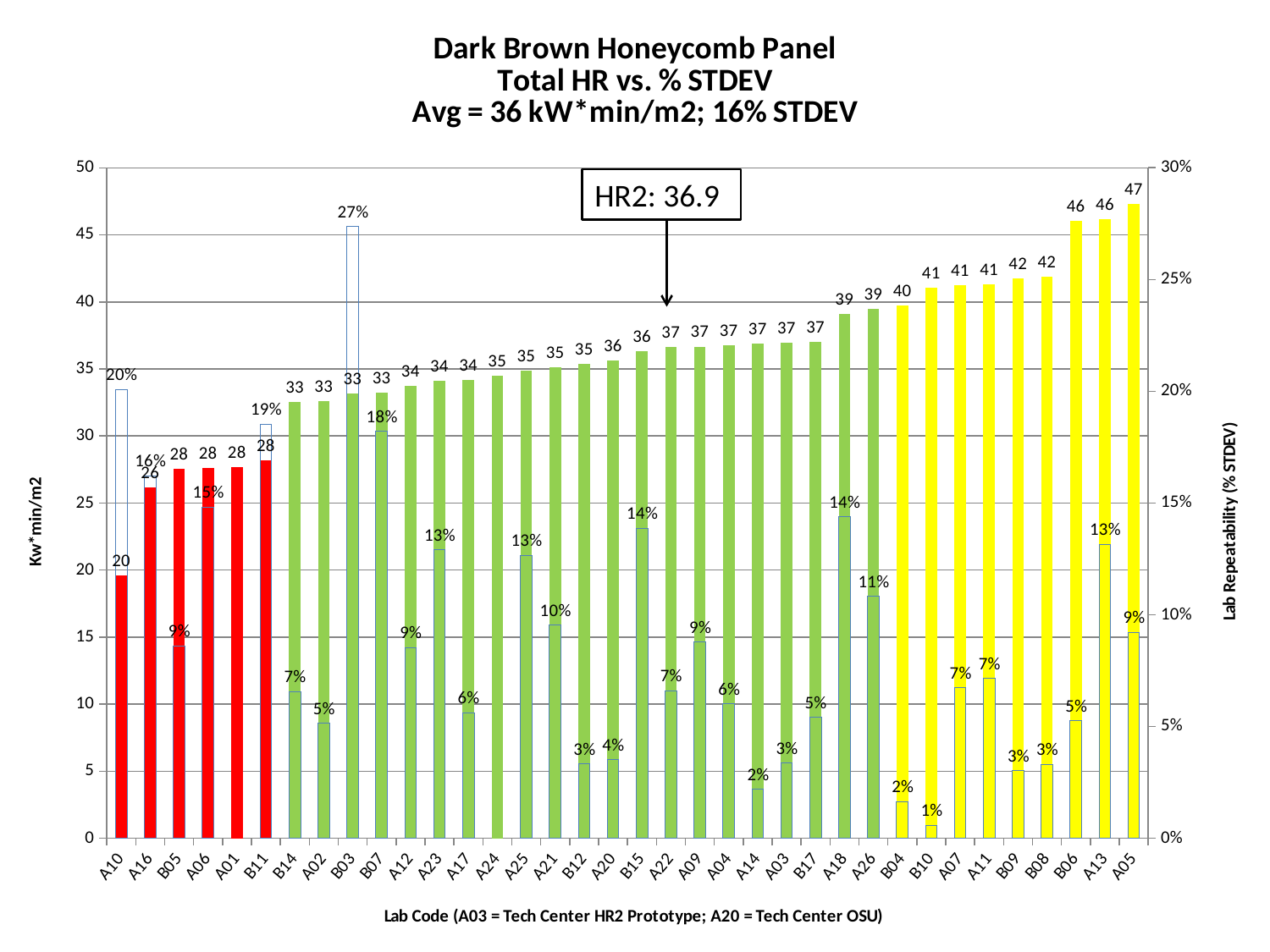
What HR2 value is shown in the annotation box on the chart? 36.9 Which lab code has the lowest Total HR value? A10 Which lab code has the highest % STDEV value? B03 What is the % STDEV value shown for lab A18? 14% Which lab code has the lowest % STDEV value? B10 Which lab has a higher Total HR value, B06 or B04? B06 How many lab codes are shown on the x axis? 36 What is the Total HR value for lab A05? 47 Which lab code has the highest Total HR value? A05 What is the lab repeatability (% STDEV) value shown for lab B03? 27% What is the difference between the Total HR values of A05 and A10? 27 What kind of chart is shown on the slide? Bar chart